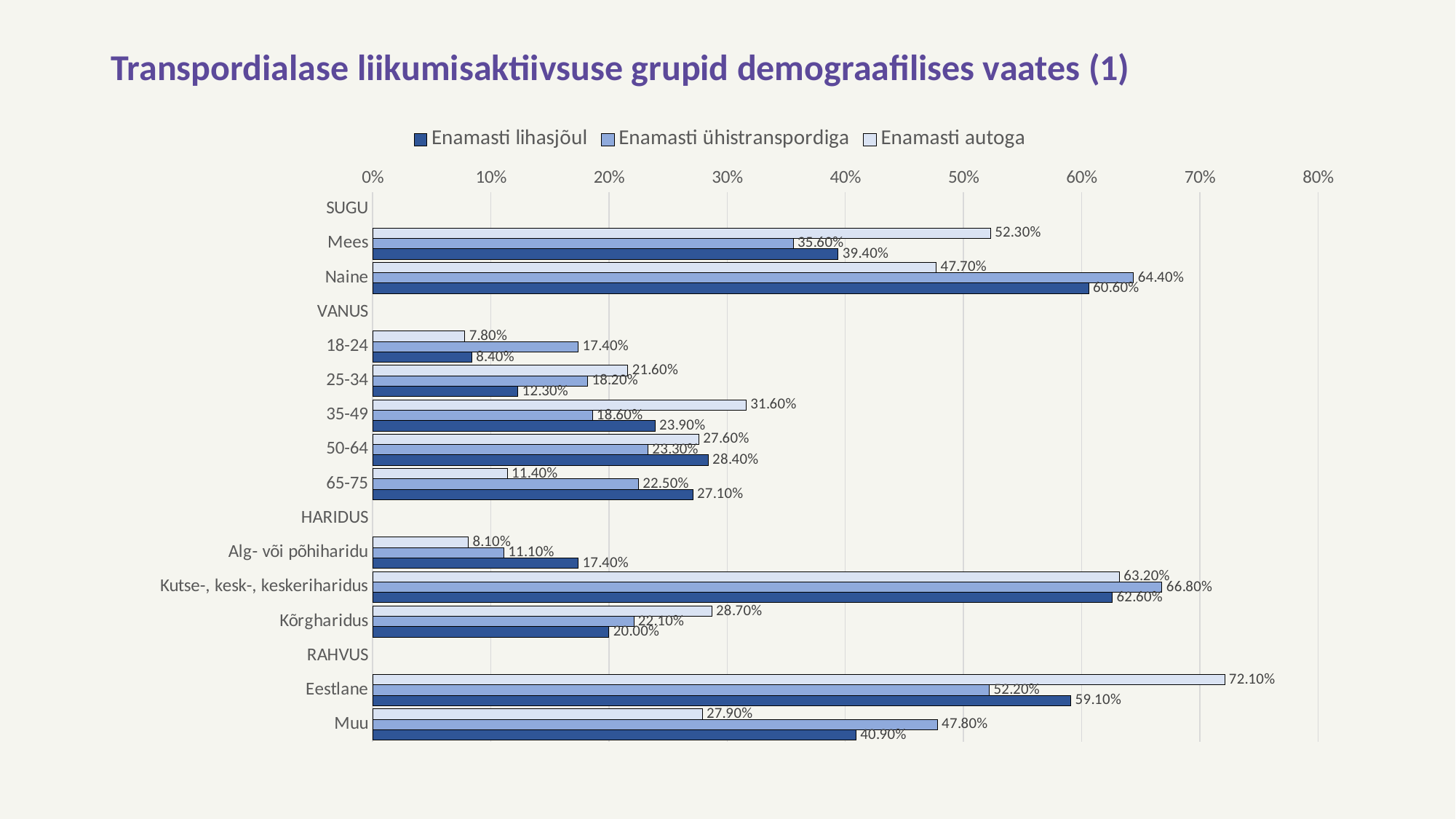
Which category has the highest value in the Enamasti autoga series? Eestlane What is the value for Naine in the Enamasti ühistranspordiga series? 64.40% Which category has the lowest value in the Enamasti lihasjõul series? 18-24 Is the Enamasti ühistranspordiga value for Kutse-, kesk-, keskeriharidus greater or less than 60%? greater What is the difference between the Enamasti autoga values for Eestlane and Muu? 44.20% What is the value for 65-75 in the Enamasti lihasjõul series? 27.10% What is the value for Mees in the Enamasti autoga series? 52.30% What kind of chart is shown on the slide? Bar chart What is the title of the chart? Transpordialase liikumisaktiivsuse grupid demograafilises vaates (1) What is the value for Kõrgharidus in the Enamasti autoga series? 28.70% Which is larger for 35-49: the Enamasti autoga value or the Enamasti lihasjõul value? Enamasti autoga How many series does the legend list? 3